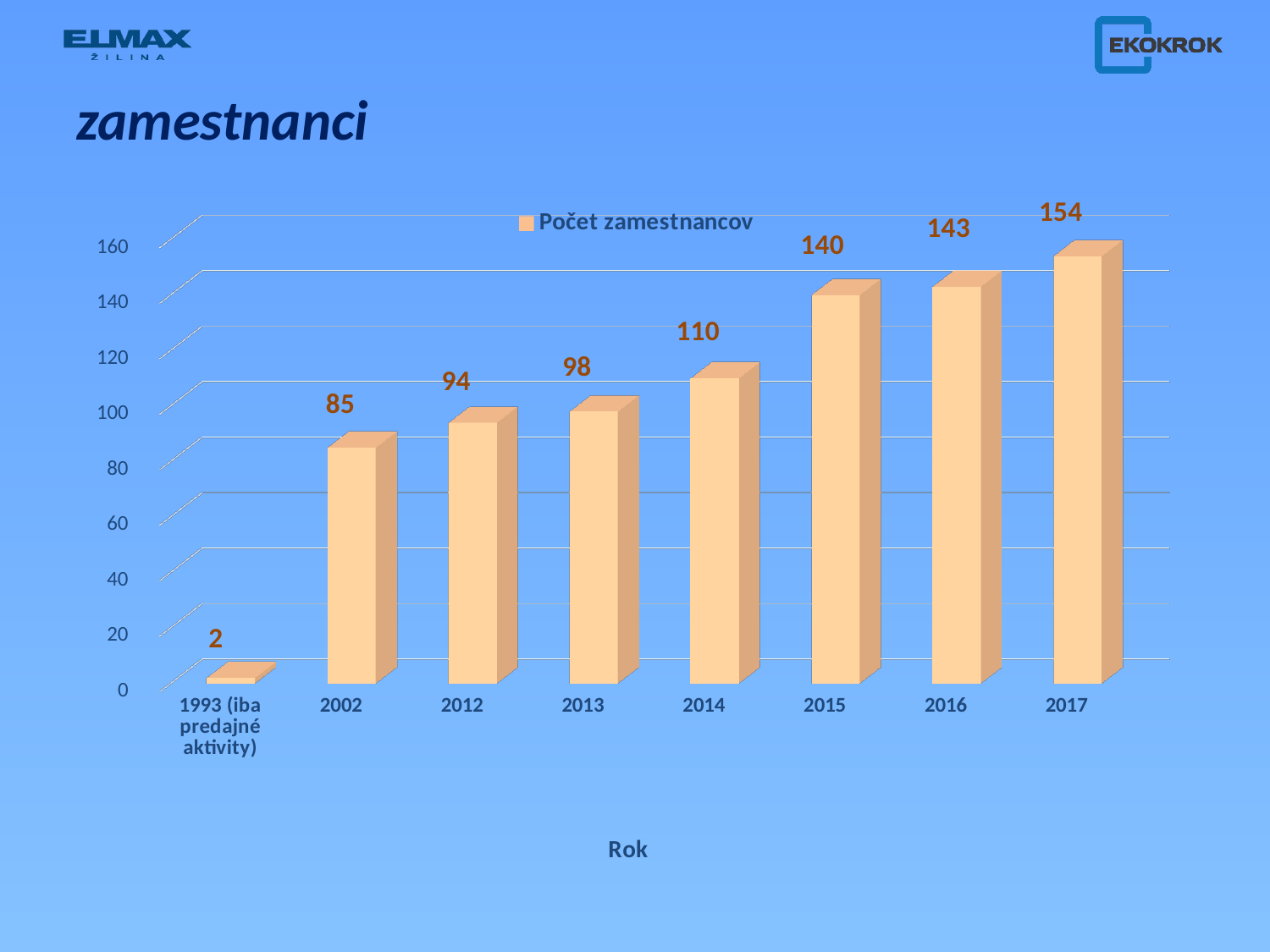
What value is shown for 2017? 154 How many series does the legend list? 1 What is the difference between the values for 2015 and 2014? 30 Do the values rise or fall from 2002 to 2017? rise Which is larger, the value for 2012 or the value for 2013? 2013 What is the number of employees (Počet zamestnancov) shown for 2014? 110 How many categories are shown on the x axis? 8 Which category has the lowest value? 1993 (iba predajné aktivity) What is the difference between the values for 2017 and 2002? 69 What value is shown for the category '1993 (iba predajné aktivity)'? 2 What kind of chart is shown on the slide? bar chart Which year has the highest number of employees? 2017